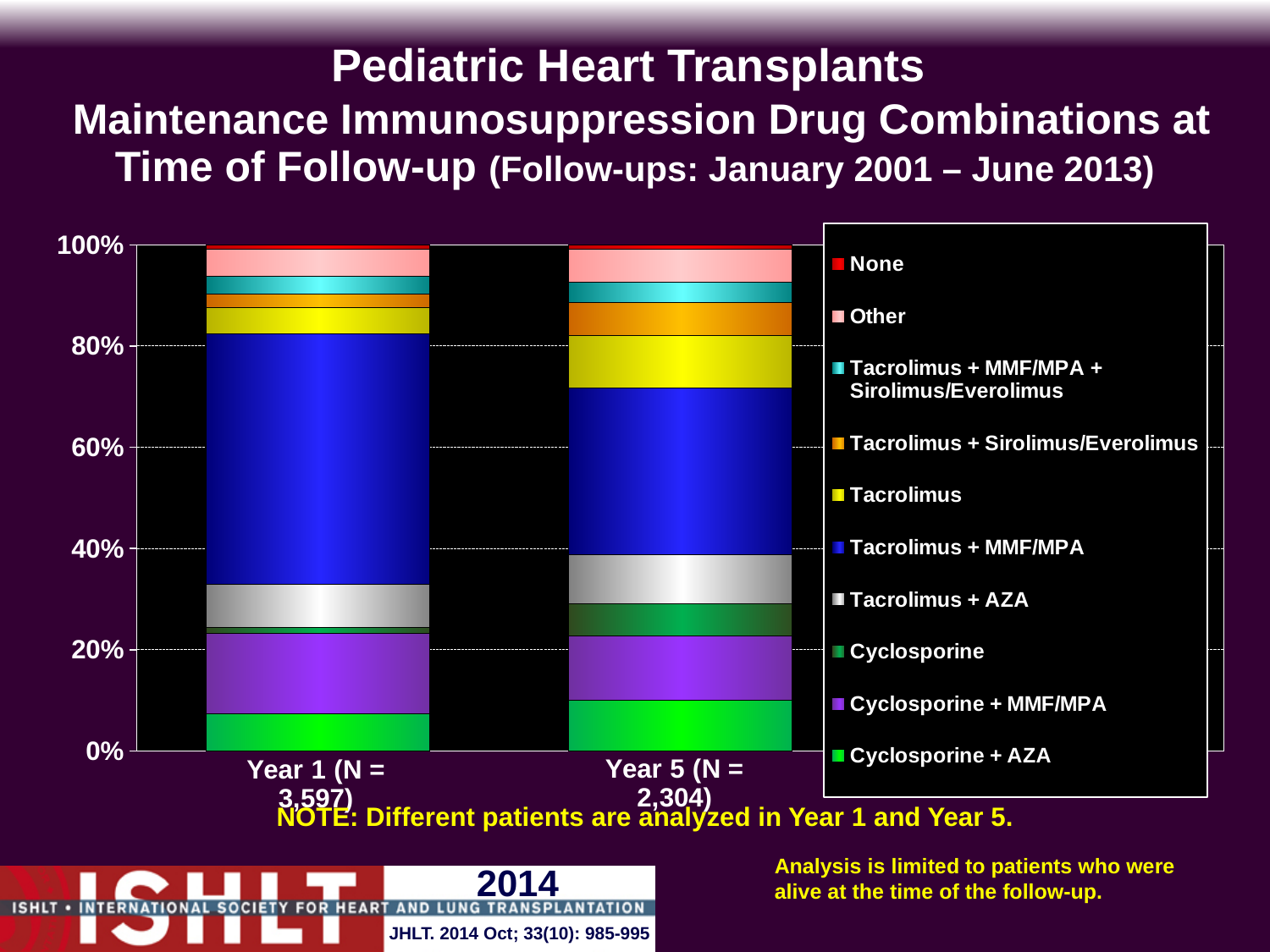
How many bars (follow-up time points) are plotted in the chart? 2 How many drug combination series does the legend list? 10 Is the share of Tacrolimus + MMF/MPA in the Year 1 bar greater or less than 40%? greater Which bar has the larger Tacrolimus + MMF/MPA segment, Year 1 or Year 5? Year 1 Which bar has the larger Cyclosporine segment, Year 1 or Year 5? Year 5 What is the sample size shown for the Year 5 bar? N = 2,304 What is the total height of the Year 5 stacked bar? 100% What kind of chart is shown on the slide? Stacked bar chart What is the sample size shown for the Year 1 bar? N = 3,597 Which legend entry is shown in blue? Tacrolimus + MMF/MPA Which bar has the larger Tacrolimus segment, Year 1 or Year 5? Year 5 Is the share of Cyclosporine + AZA in the Year 1 bar greater or less than 20%? less